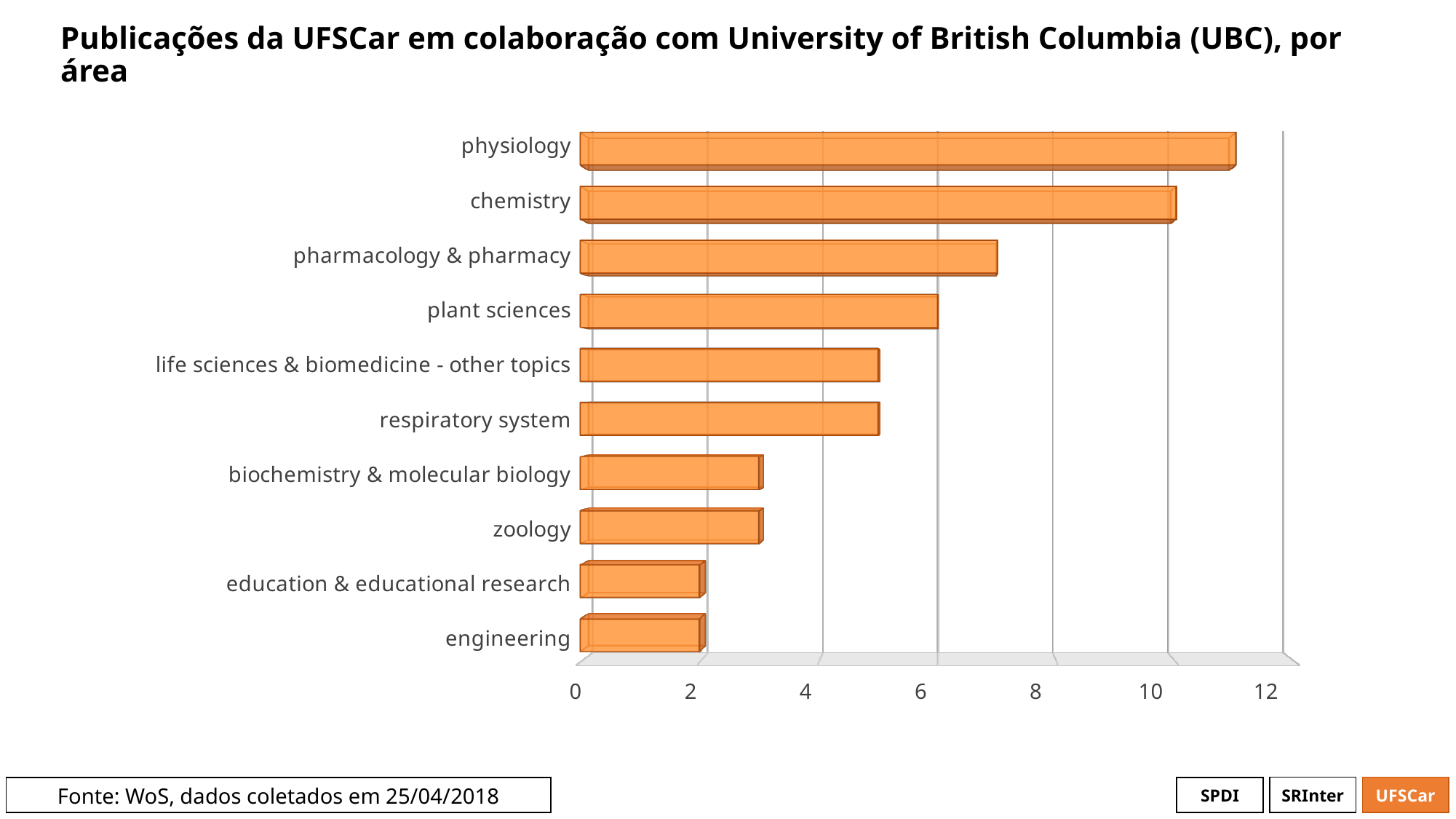
Is the value for plant sciences greater or less than 8? less Is the value for engineering greater or less than 4? less How many areas (categories) are shown in the chart? 10 What colour are the bars in the chart? orange Is the value for physiology greater or less than 10? greater What kind of chart is shown on the slide? bar chart Which is larger, the value for chemistry or the value for pharmacology & pharmacy? chemistry Which area has the highest number of publications? physiology